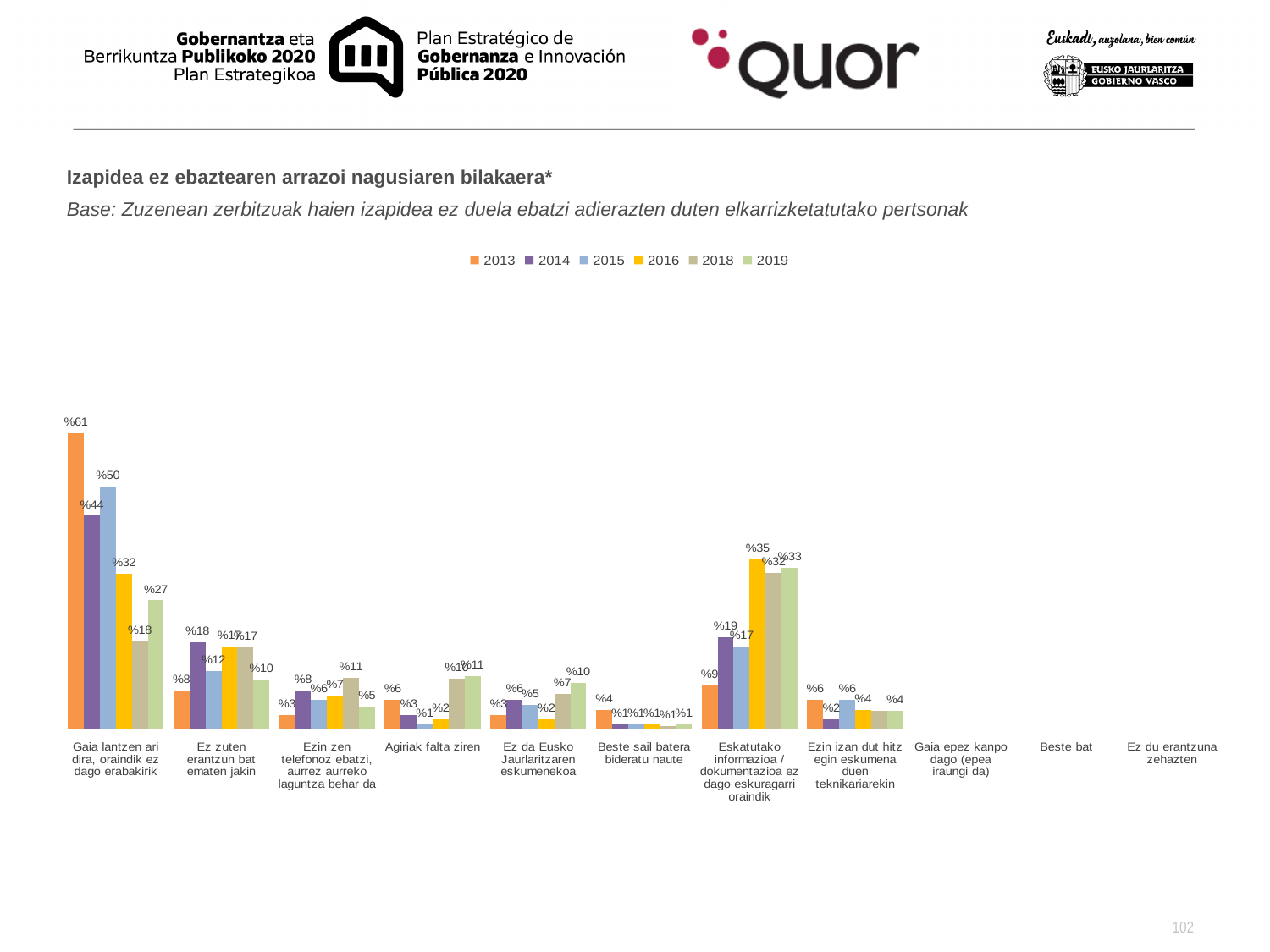
What is the 2013 value for "Beste sail batera bideratu naute"? %4 Which year has the highest value for "Gaia lantzen ari dira, oraindik ez dago erabakirik"? 2013 How many series does the legend list? 6 Which year has the lowest value for "Gaia lantzen ari dira, oraindik ez dago erabakirik"? 2018 Which year is shown in orange in the legend? 2013 What is the difference between the 2013 and 2019 values for "Gaia lantzen ari dira, oraindik ez dago erabakirik"? 34 percentage points For 2013, which is larger: "Gaia lantzen ari dira, oraindik ez dago erabakirik" or "Eskatutako informazioa / dokumentazioa ez dago eskuragarri oraindik"? Gaia lantzen ari dira, oraindik ez dago erabakirik What is the 2015 value for "Gaia lantzen ari dira, oraindik ez dago erabakirik"? %50 What is the 2014 value for "Ez zuten erantzun bat ematen jakin"? %18 What is the 2013 value for "Gaia lantzen ari dira, oraindik ez dago erabakirik"? %61 What kind of chart is shown on the slide? bar chart What is the 2016 value for "Eskatutako informazioa / dokumentazioa ez dago eskuragarri oraindik"? %35